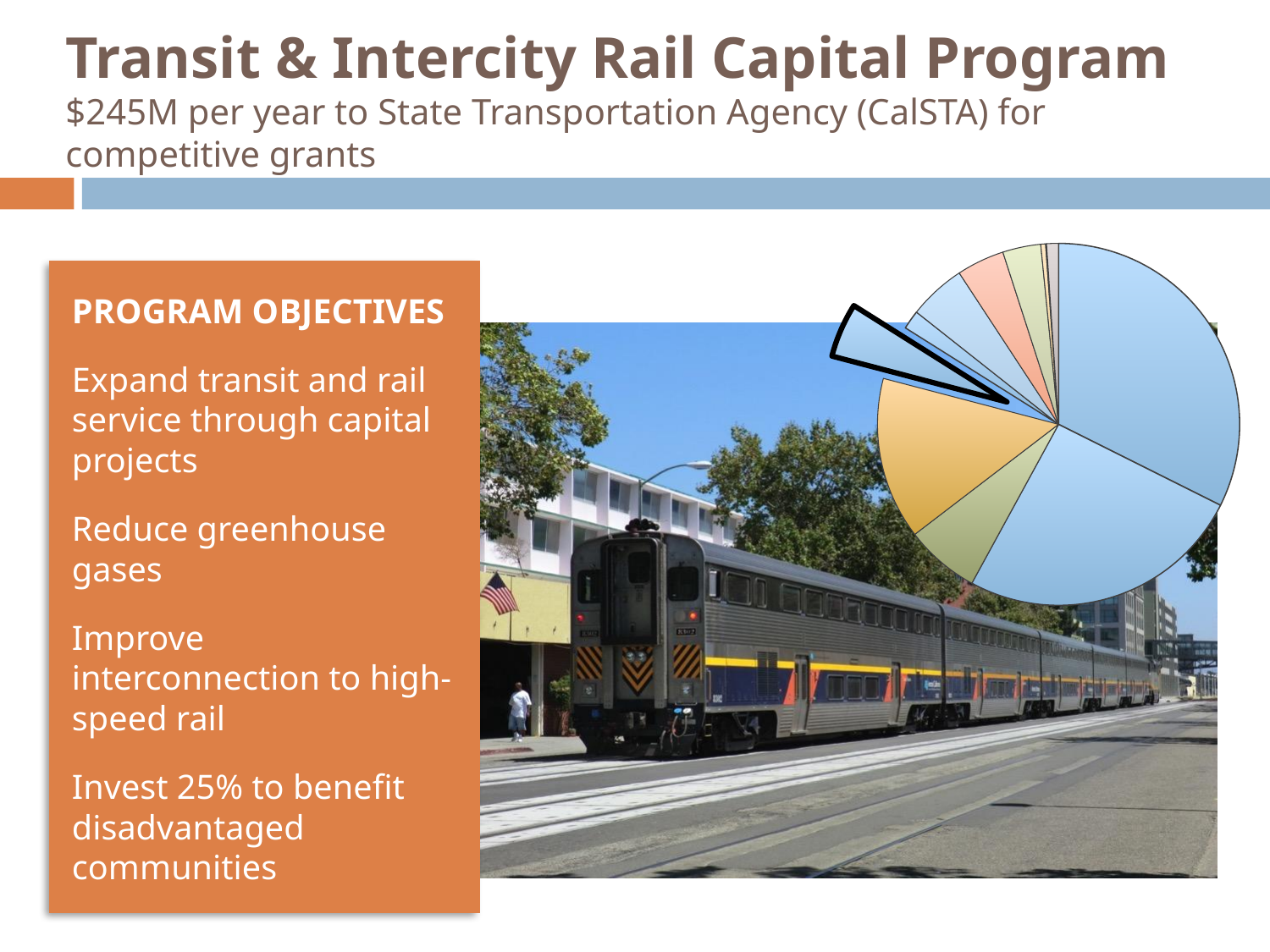
What kind of chart is shown on the right side of the slide? pie chart Which slice of the pie chart is pulled out from the pie and outlined in black? the small blue slice Which colour slice is the largest in the pie chart? blue Does the pie chart display a legend or data labels? No